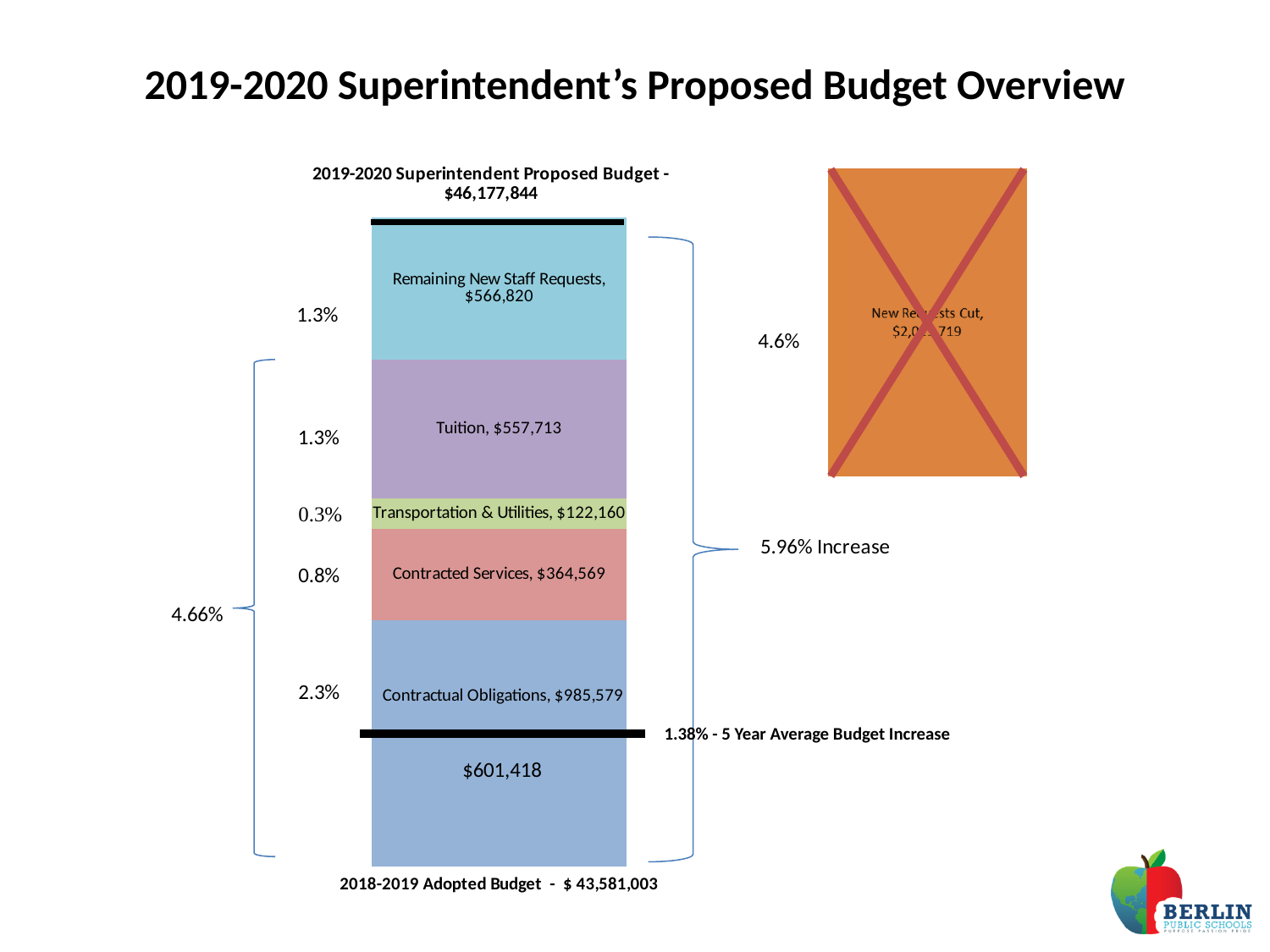
What is the difference between the Remaining New Staff Requests value and the Tuition value? $9,107 What is the value shown for Contracted Services? $364,569 What is the value shown for Tuition in the stacked bar? $557,713 What kind of chart is shown on the slide? Bar chart Which labeled segment of the stacked bar has the largest value? Contractual Obligations Which is larger, Contracted Services or Tuition? Tuition What percentage is shown next to the Contracted Services segment? 0.8% What is the value shown for Remaining New Staff Requests? $566,820 What is the value shown for Contractual Obligations? $985,579 What is the value shown for Transportation & Utilities? $122,160 What total amount is given in the chart title for the 2019-2020 Superintendent Proposed Budget? $46,177,844 Which labeled segment of the stacked bar has the smallest value? Transportation & Utilities